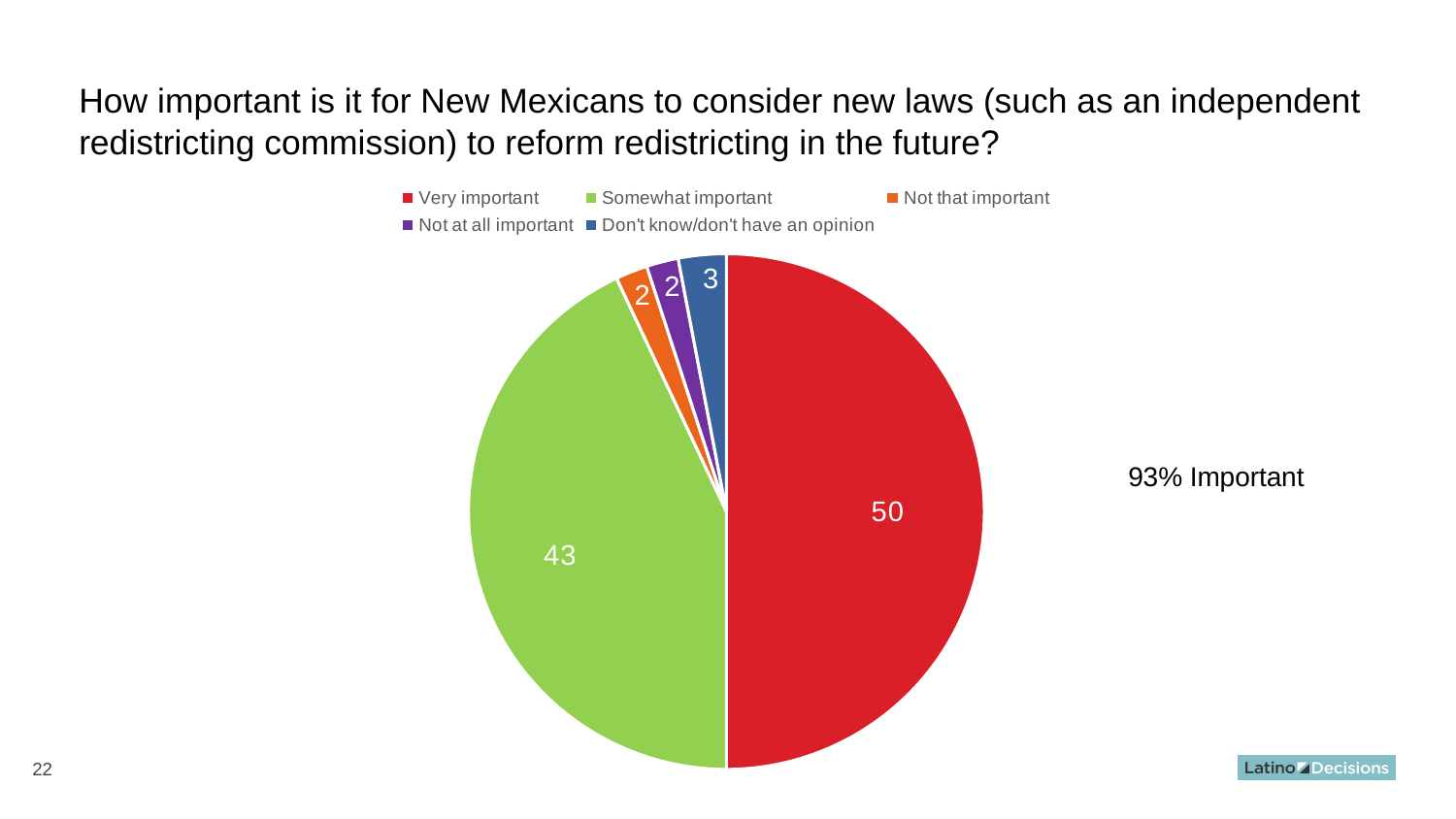
Which is larger, the value for "Don't know/don't have an opinion" or the value for "Not at all important"? Don't know/don't have an opinion What kind of chart is shown on the slide? pie chart How many categories does the legend list? 5 What is the value for "Somewhat important"? 43 What is the value for "Very important"? 50 Which category has the largest slice of the pie? Very important What is the value for "Not that important"? 2 What share of the pie does the "Very important" slice represent? 50% What is the total of all the slice values shown on the pie? 100 What is the difference between the values for "Very important" and "Somewhat important"? 7 What is the value for "Don't know/don't have an opinion"? 3 What colour is the "Somewhat important" slice? green